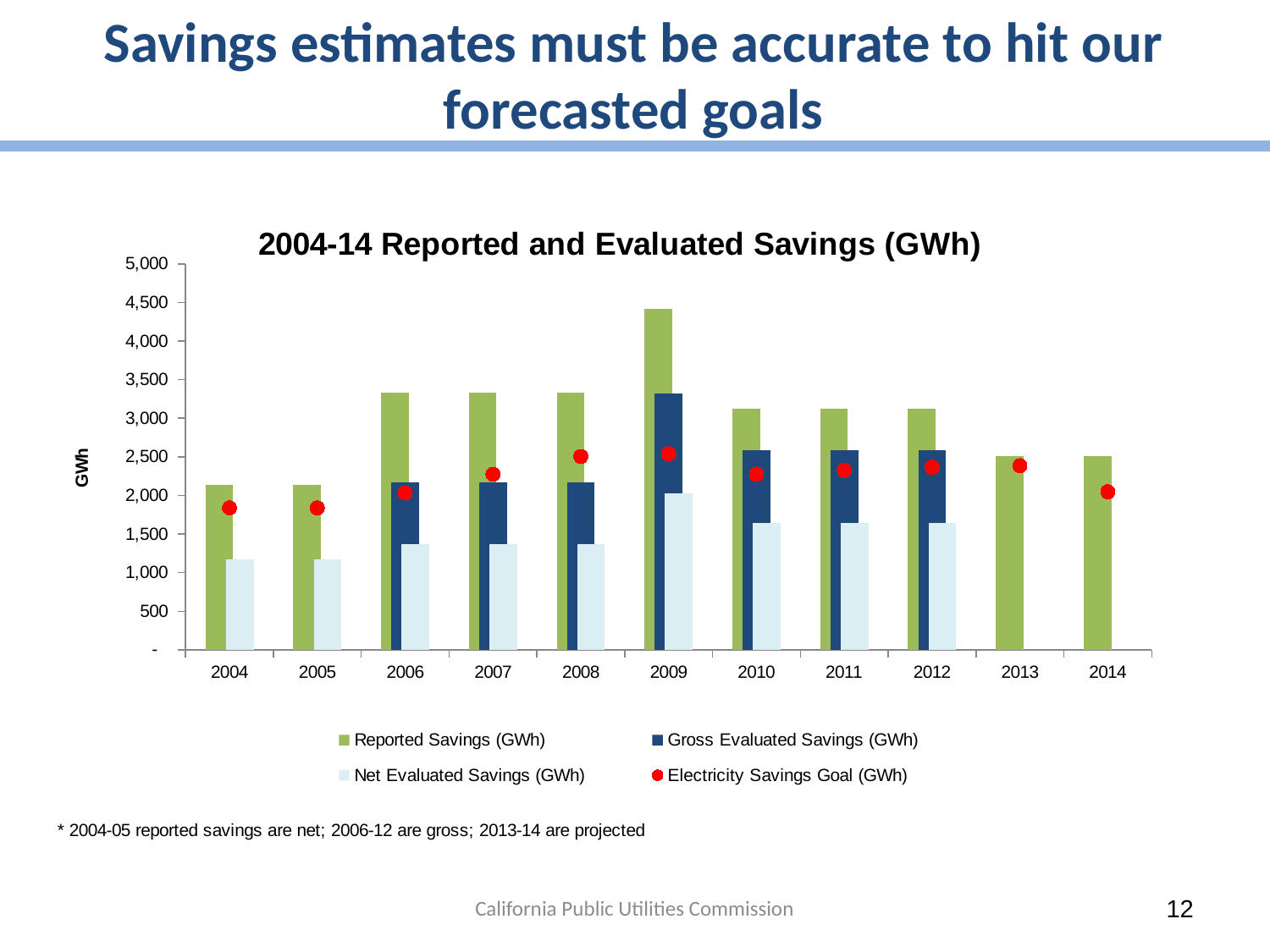
Is the Gross Evaluated Savings value for 2010 greater or less than 2,000? greater How many years are shown on the x axis? 11 Is the Reported Savings value for 2009 greater or less than 4,000? greater Which year has the highest Reported Savings (GWh)? 2009 Which year has the highest Gross Evaluated Savings (GWh)? 2009 Is the Net Evaluated Savings value for 2004 greater or less than 1,500? less What is the title of the chart? 2004-14 Reported and Evaluated Savings (GWh) Which year has the highest Net Evaluated Savings (GWh)? 2009 Which is larger, the Reported Savings for 2008 or for 2009? 2009 How many series does the legend list? 4 What kind of chart is shown on the slide? Bar chart